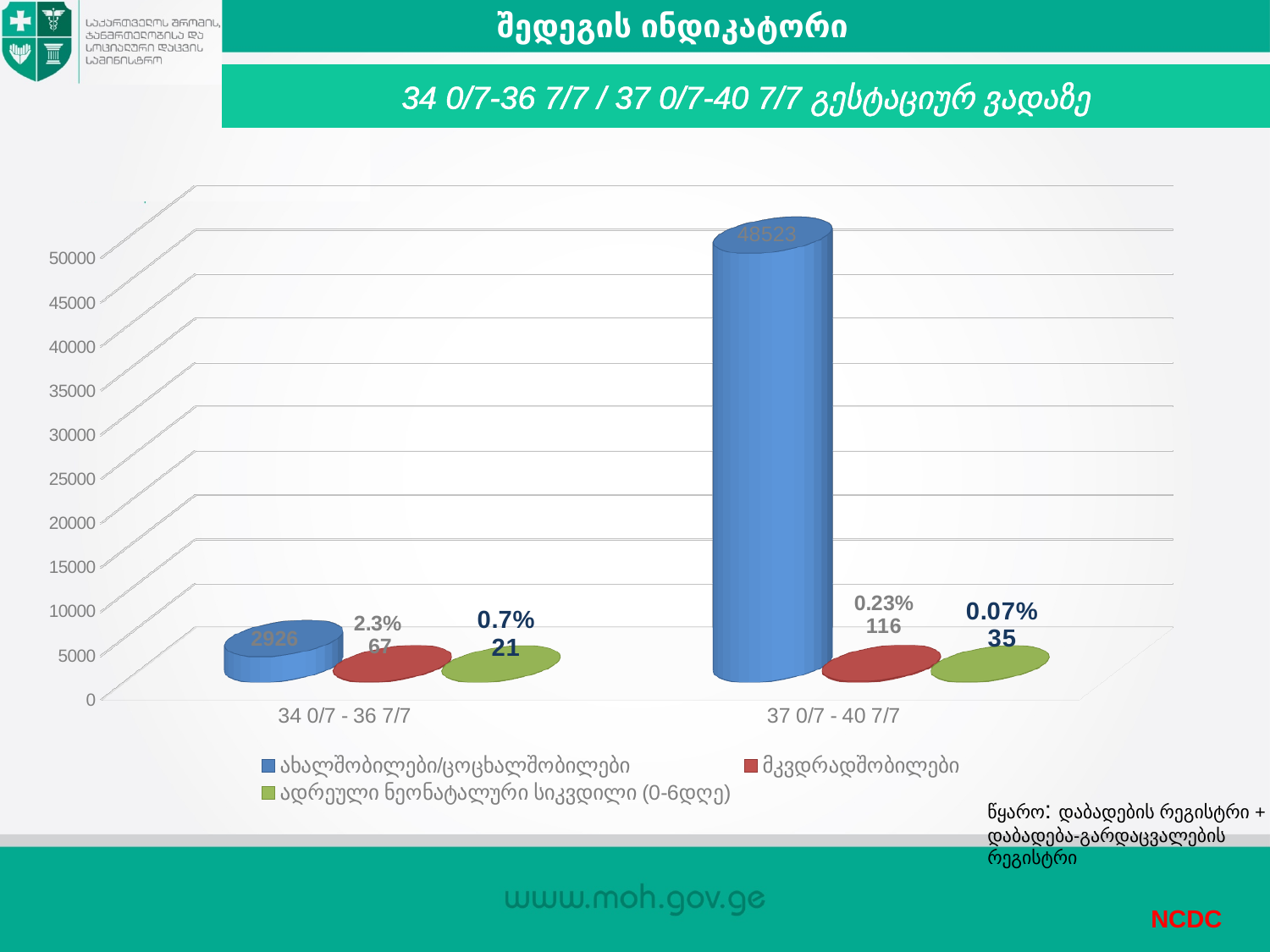
Is the value of the blue bar for 37 0/7 - 40 7/7 greater or less than 45000? greater What is the value of the red series (მკვდრადშობილები) for the category 34 0/7 - 36 7/7? 67 Which category has the higher value for the blue series (ახალშობილები/ცოცხალშობილები)? 37 0/7 - 40 7/7 How many series does the legend list? 3 What is the value of the blue series (ახალშობილები/ცოცხალშობილები) for the category 34 0/7 - 36 7/7? 2926 What percentage is shown above the red bar for the category 37 0/7 - 40 7/7? 0.23% What is the value of the blue series (ახალშობილები/ცოცხალშობილები) for the category 37 0/7 - 40 7/7? 48523 What percentage is shown above the green bar for the category 34 0/7 - 36 7/7? 0.7% What is the difference between the red series values for 37 0/7 - 40 7/7 and 34 0/7 - 36 7/7? 49 What type of chart is shown on the slide? bar chart What is the value of the green series (ადრეული ნეონატალური სიკვდილი) for the category 37 0/7 - 40 7/7? 35 How many categories are shown on the x axis? 2